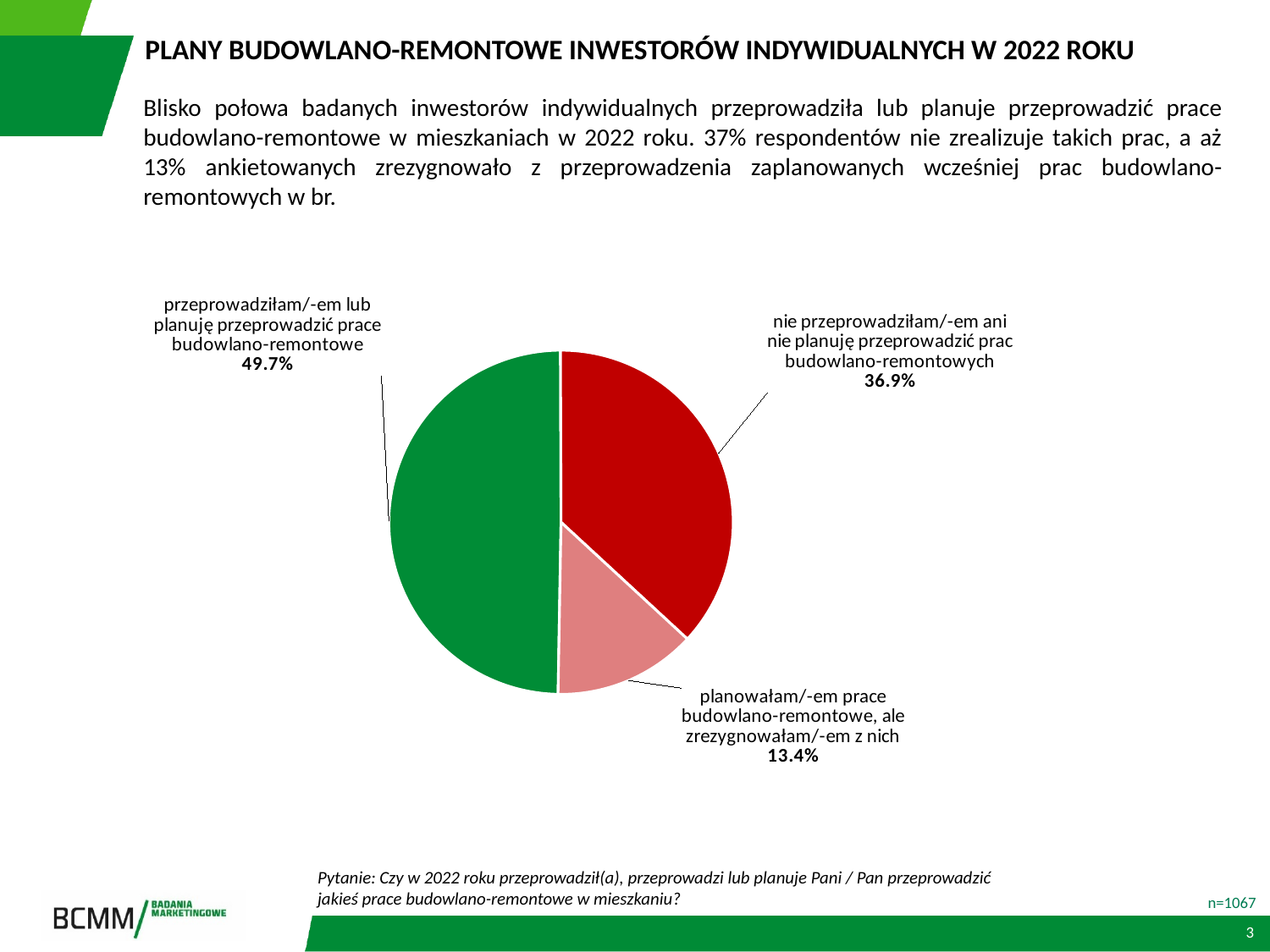
Which category has the largest slice of the pie? przeprowadziłam/-em lub planuję przeprowadzić prace budowlano-remontowe What sample size (n) is stated on the slide? n=1067 What kind of chart is shown on the slide? pie chart What share of respondents carried out or plan to carry out construction/renovation work ("przeprowadziłam/-em lub planuję przeprowadzić prace budowlano-remontowe")? 49.7% What share of respondents neither carried out nor plan construction/renovation work ("nie przeprowadziłam/-em ani nie planuję przeprowadzić prac budowlano-remontowych")? 36.9% Which category has the smallest slice of the pie? planowałam/-em prace budowlano-remontowe, ale zrezygnowałam/-em z nich What colour is the slice for respondents who planned work but gave it up (13.4%)? pink (light red) Which is larger: the share who neither carried out nor plan work, or the share who planned work but gave it up? nie przeprowadziłam/-em ani nie planuję przeprowadzić prac budowlano-remontowych How many categories are shown in the pie chart? 3 What is the difference in percentage points between the 36.9% slice and the 13.4% slice? 23.5 percentage points What is the difference in percentage points between the largest slice (49.7%) and the slice for those who neither carried out nor plan work (36.9%)? 12.8 percentage points What share of respondents planned construction/renovation work but gave it up ("planowałam/-em prace budowlano-remontowe, ale zrezygnowałam/-em z nich")? 13.4%